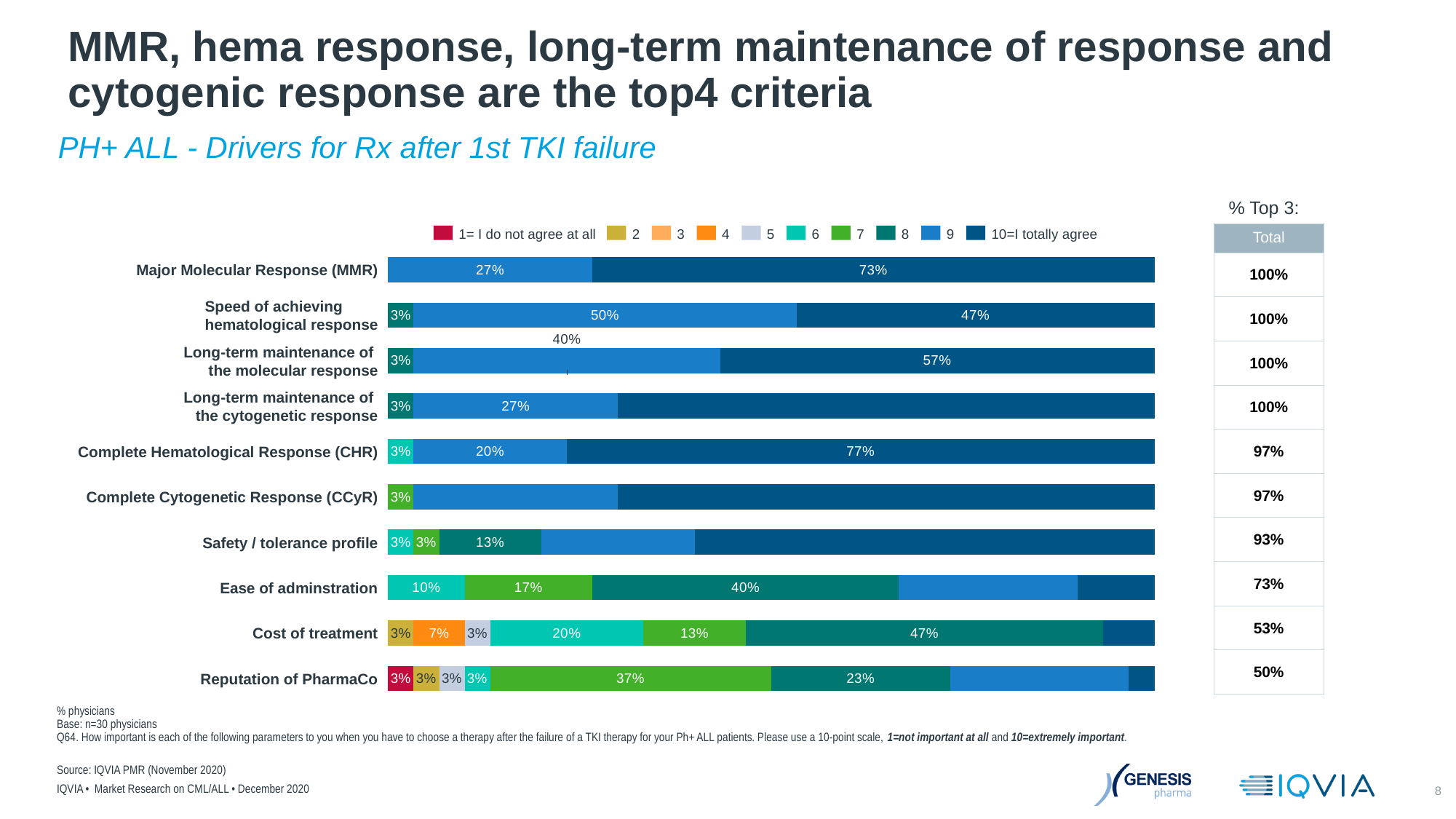
Which criterion has the largest share of physicians rating it 10=I totally agree? Complete Hematological Response (CHR) Which criterion has the lowest % Top 3 total? Reputation of PharmaCo Which has a higher % Top 3 total, Safety / tolerance profile or Ease of adminstration? Safety / tolerance profile What percentage of physicians gave Complete Hematological Response (CHR) a rating of 10=I totally agree? 77% What is the difference between the 10=I totally agree share and the 9 share for Major Molecular Response (MMR)? 46 percentage points What is the subtitle of the chart on the slide? PH+ ALL - Drivers for Rx after 1st TKI failure What type of chart is shown on the slide? Stacked bar chart How many criteria are shown in the chart? 10 How many rating levels does the legend list? 10 What is the % Top 3 total for Cost of treatment? 53% What percentage of physicians rated Major Molecular Response (MMR) as 10=I totally agree? 73% What percentage of physicians rated Ease of adminstration with an 8? 40%